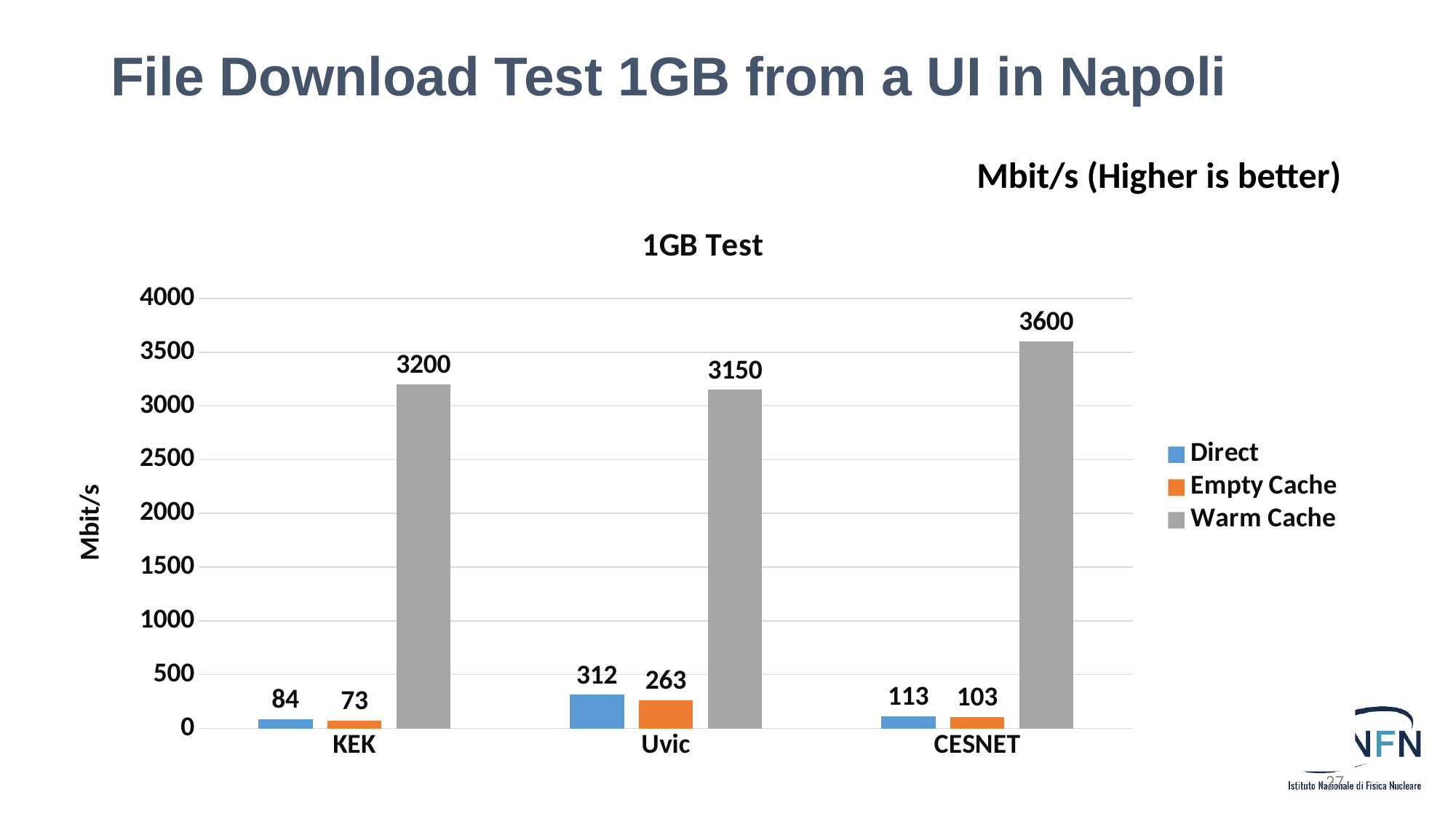
Which site has the highest Warm Cache value? CESNET What is the Empty Cache value for KEK? 73 Which site has the lowest Direct value? KEK Which is larger, the Direct value for CESNET or the Direct value for Uvic? Uvic What kind of chart is shown? bar chart How many series does the legend list? 3 What is the difference between the Warm Cache values for CESNET and KEK? 400 What is the difference between the Direct and Empty Cache values for Uvic? 49 Is the Warm Cache value for Uvic greater or less than 3000? greater What is the Warm Cache value for CESNET? 3600 How many sites are shown on the x axis? 3 What is the Direct value for Uvic? 312